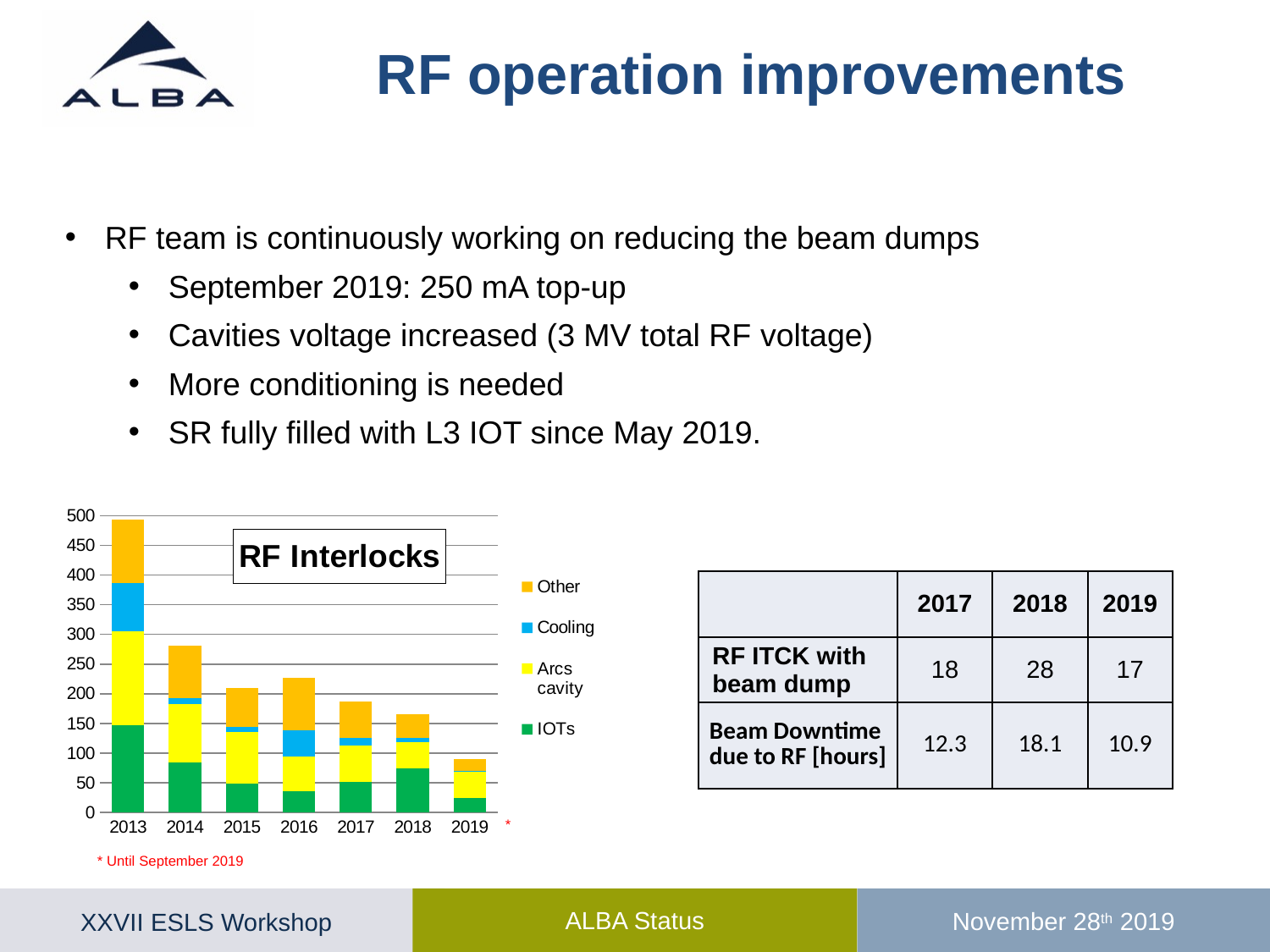
Which year has the lowest total number of RF interlocks? 2019 Is the total RF interlocks value for 2014 greater or less than 250? greater Which year has a larger total of RF interlocks, 2014 or 2015? 2014 How many series does the legend of the RF Interlocks chart list? 4 Do the total RF interlocks generally rise or fall from 2013 to 2019? Fall Which series in the RF Interlocks chart is shown in green? IOTs How many years are shown on the x axis of the RF Interlocks chart? 7 Which year has a larger total of RF interlocks, 2016 or 2017? 2016 Is the total RF interlocks value for 2013 greater or less than 450? greater Which year has the highest total number of RF interlocks? 2013 Is the total RF interlocks value for 2019 greater or less than 100? less What kind of chart is the RF Interlocks chart? Stacked bar chart